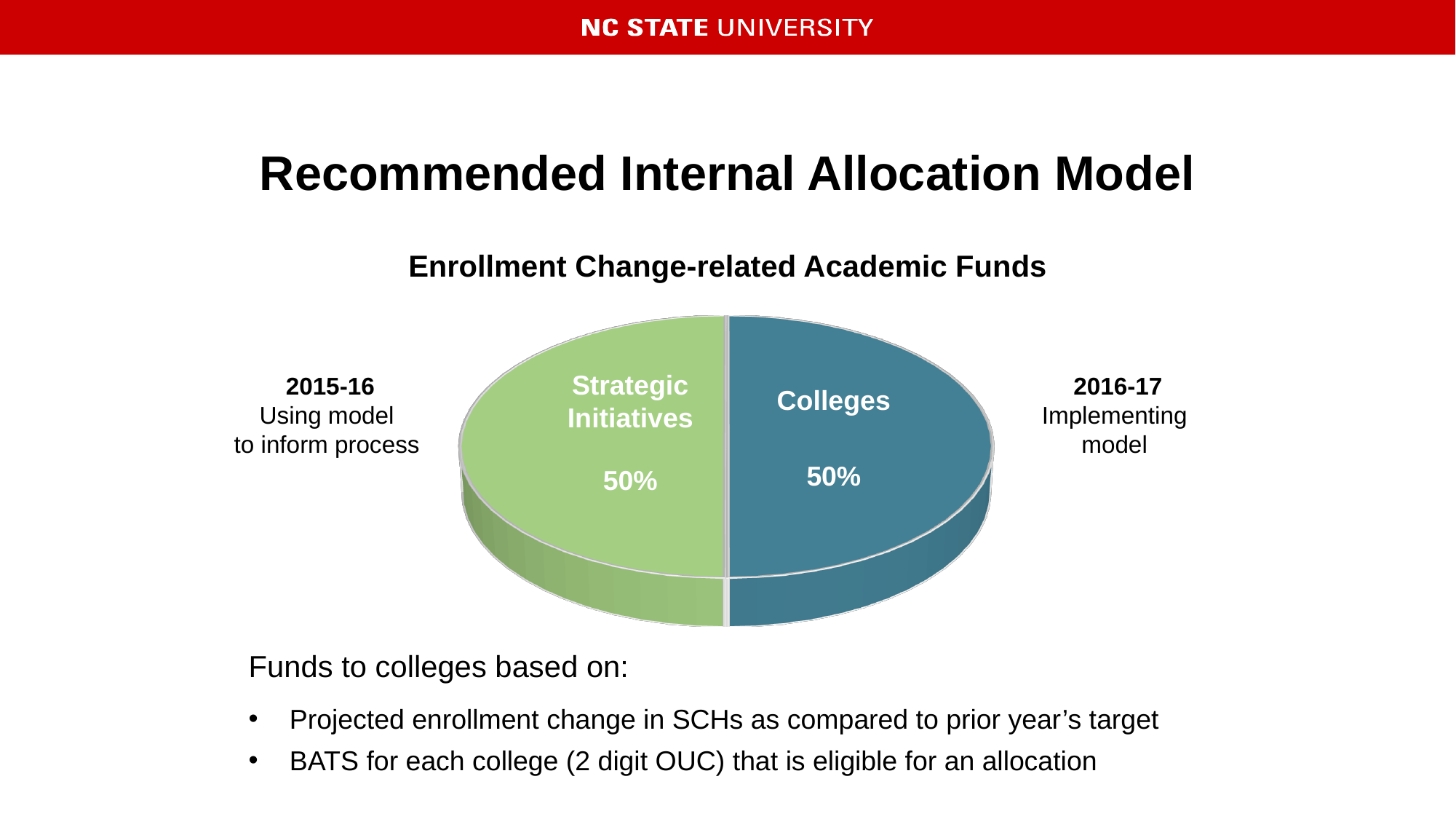
What is the title of the chart? Enrollment Change-related Academic Funds What is the combined share of the Colleges and Strategic Initiatives slices? 100% Is the share for Colleges greater or less than 25%? greater What kind of chart is shown on the slide? Pie chart What is the difference between the Colleges share and the Strategic Initiatives share? 0% What colour is the Colleges slice? Blue What share of the pie is labelled Colleges? 50% What share of the pie is labelled Strategic Initiatives? 50% Is the share for Strategic Initiatives greater or less than 75%? less How many slices does the pie chart have? 2